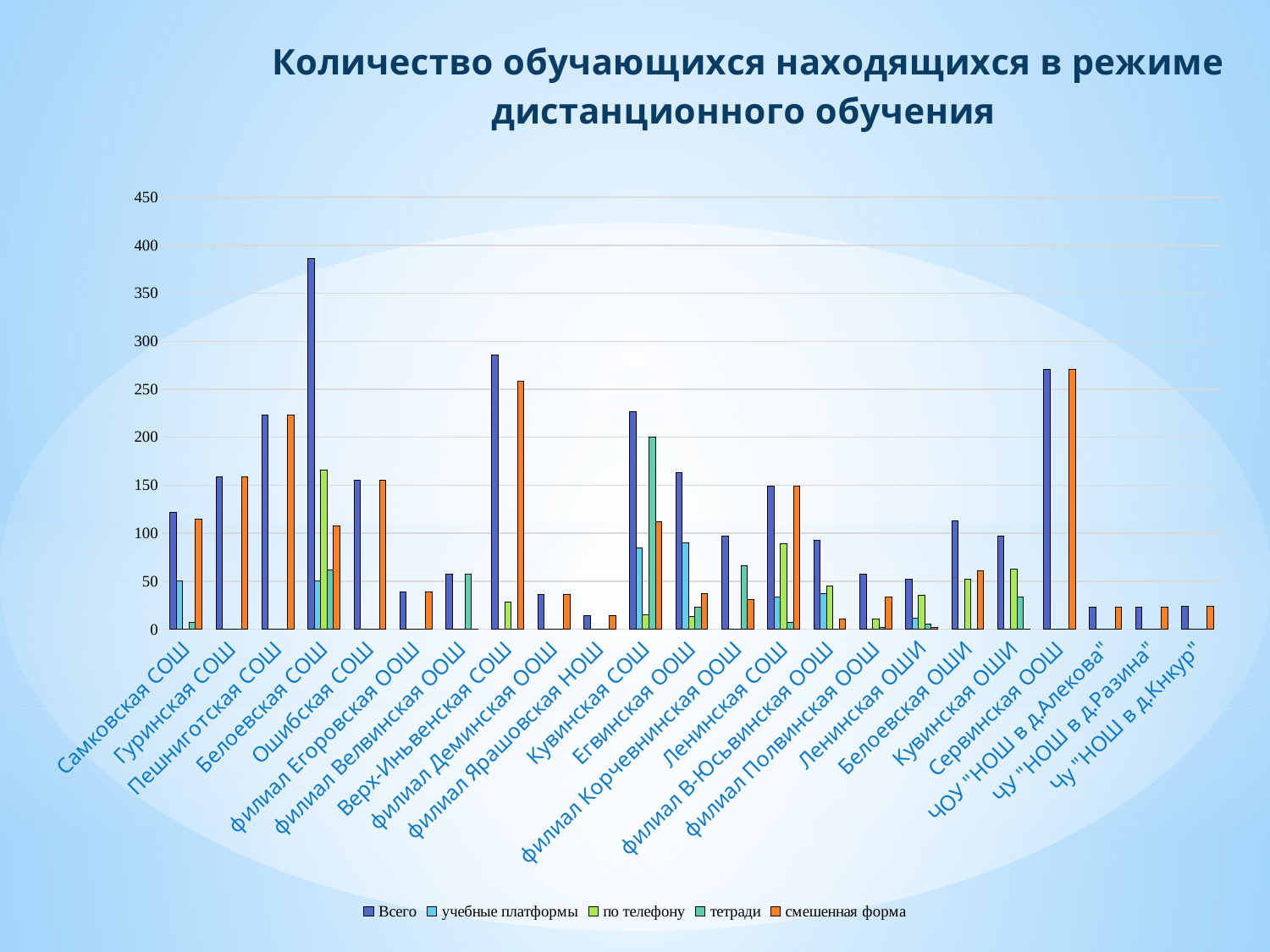
What is the title of the chart? Количество обучающихся находящихся в режиме дистанционного обучения Which school has the highest value for the series "смешенная форма"? Сервинская ООШ Which is larger, the "Всего" value for Белоевская СОШ or for Сервинская ООШ? Белоевская СОШ How many schools (categories) are shown on the x axis? 23 Is the value of "Всего" for Верх-Иньвенская СОШ greater or less than 250? greater Which school has the highest value for the series "Всего"? Белоевская СОШ Which school has the highest value for the series "тетради"? Кувинская СОШ What kind of chart is shown on the slide? bar chart Is the value of "Всего" for Самковская СОШ greater or less than 100? greater How many series does the legend list? 5 Is the value of "Всего" for Белоевская СОШ greater or less than 350? greater Which school has the lowest value for the series "Всего"? филиал Ярашовская НОШ